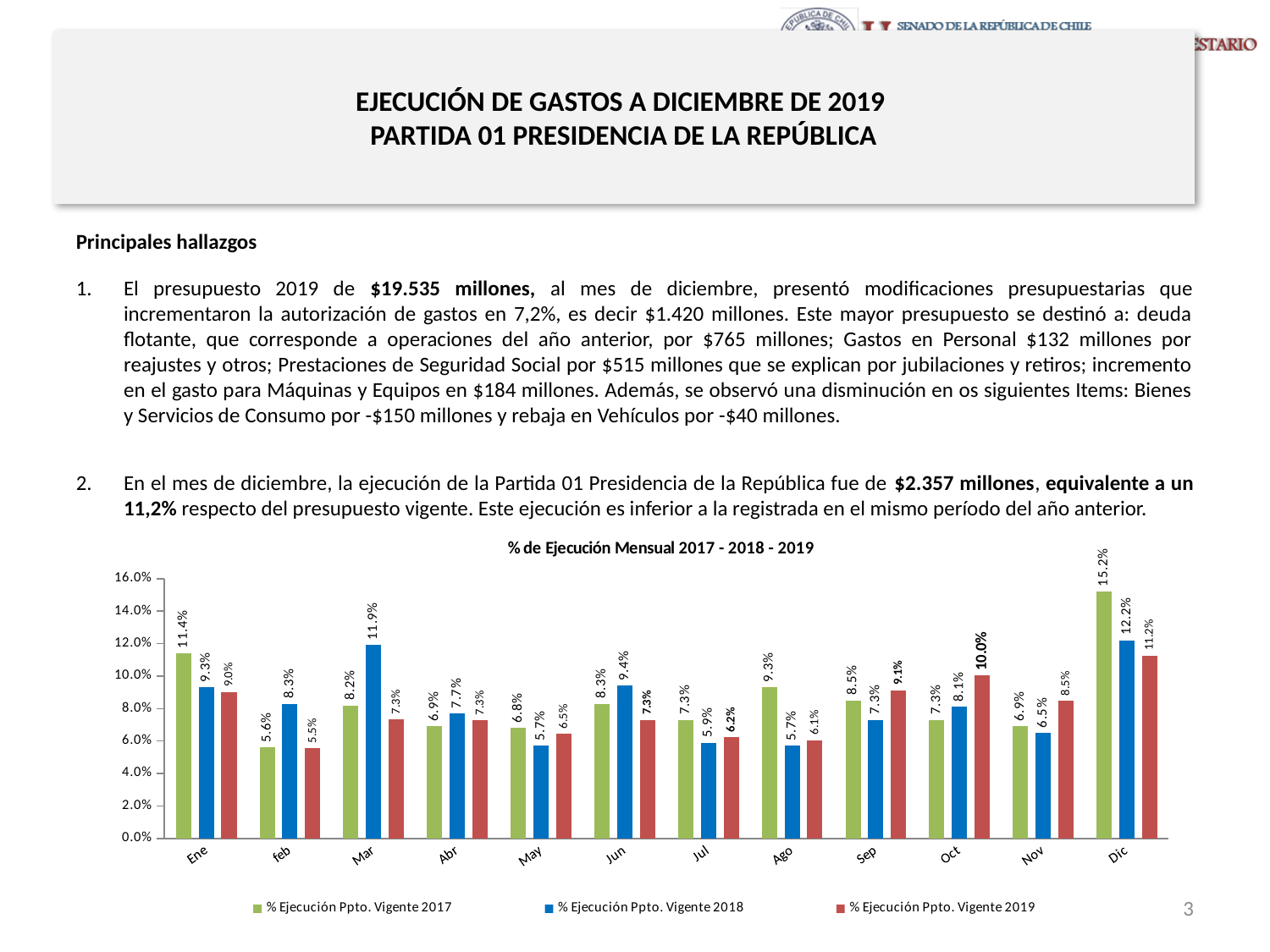
What is the title of the chart? % de Ejecución Mensual 2017 - 2018 - 2019 What kind of chart is shown? Bar chart What is the value for Oct in the % Ejecución Ppto. Vigente 2019 series? 10.0% Which month has the highest value in the % Ejecución Ppto. Vigente 2017 series? Dic What is the value for Mar in the % Ejecución Ppto. Vigente 2018 series? 11.9% What is the value for Dic in the % Ejecución Ppto. Vigente 2019 series? 11.2% Is the value for Ene in the 2017 series greater or less than 10.0%? greater Which is larger for Sep: the 2018 value or the 2019 value? 2019 value How many months are shown on the x axis? 12 What is the difference between the 2017 and 2019 values for Dic? 4.0% Which month has the lowest value in the % Ejecución Ppto. Vigente 2019 series? Feb How many series does the legend list? 3